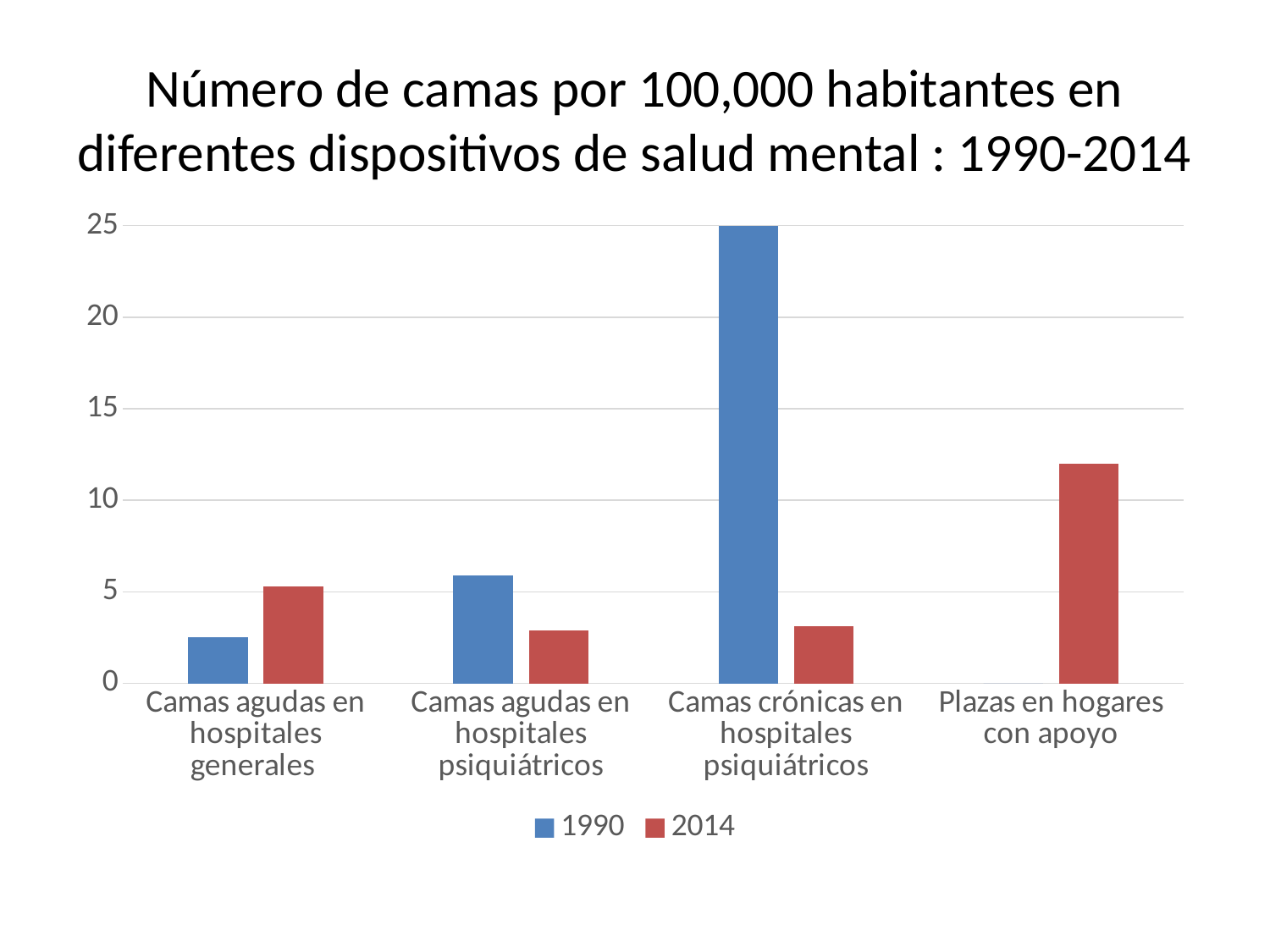
Is the 1990 value for Camas agudas en hospitales generales greater or less than 5? less How many categories are shown on the x axis? 4 Which category has the lowest 1990 value among those with a 1990 bar? Camas agudas en hospitales generales Which category has the highest 1990 value? Camas crónicas en hospitales psiquiátricos Is the 2014 value for Plazas en hogares con apoyo greater or less than 10? greater For Camas agudas en hospitales generales, which is larger, the 1990 value or the 2014 value? 2014 Which colour represents the 2014 series in the legend? red Which category has the highest 2014 value? Plazas en hogares con apoyo What kind of chart is shown on the slide? bar chart For Camas agudas en hospitales psiquiátricos, which is larger, the 1990 value or the 2014 value? 1990 How many series does the legend list? 2